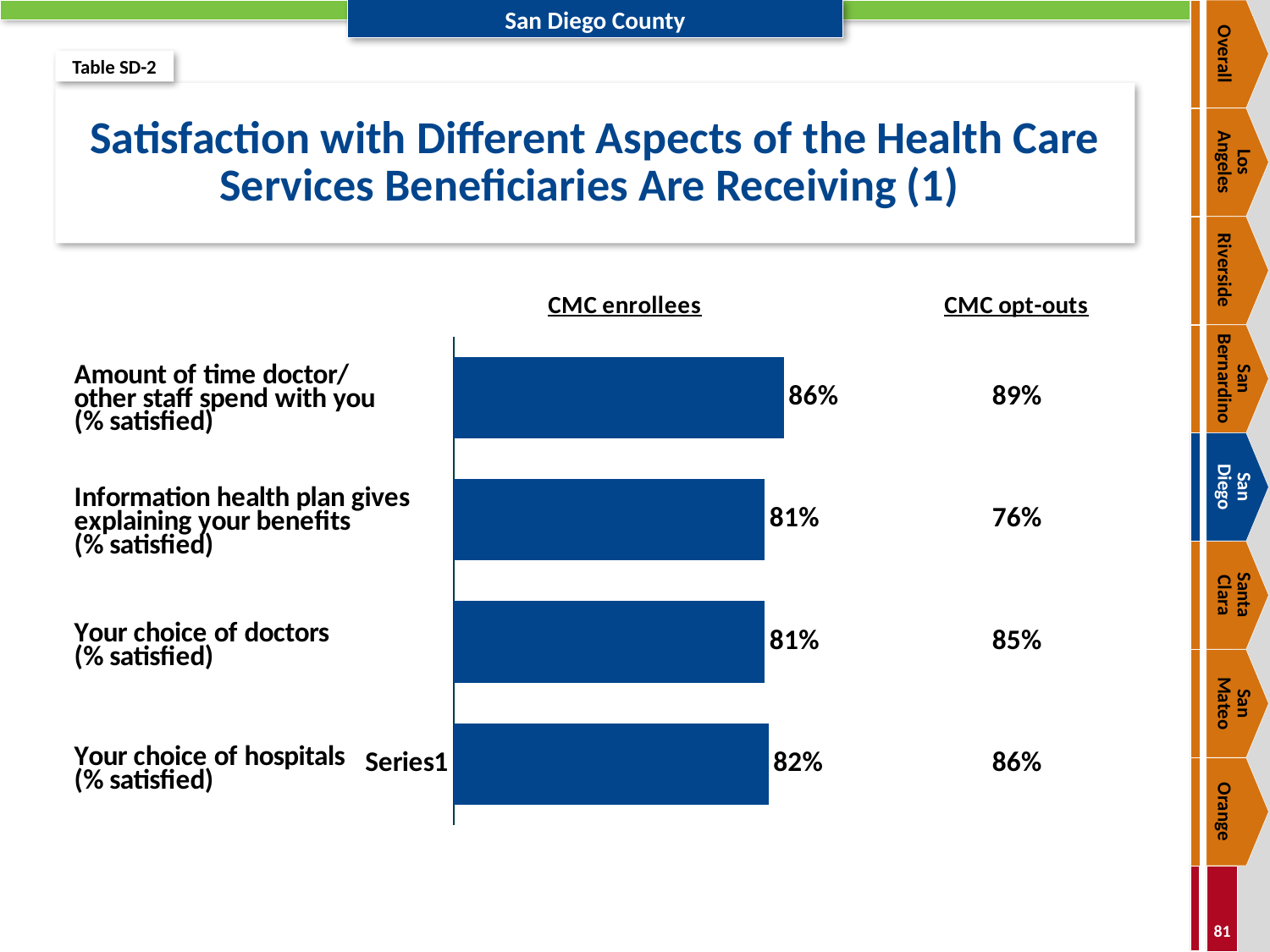
What is the title of the chart on the slide? Satisfaction with Different Aspects of the Health Care Services Beneficiaries Are Receiving (1) What is the CMC enrollees value for 'Amount of time doctor/other staff spend with you (% satisfied)'? 86% How many categories are shown in the chart? 4 What is the CMC opt-outs value for 'Information health plan gives explaining your benefits (% satisfied)'? 76% What is the CMC enrollees value for 'Your choice of hospitals (% satisfied)'? 82% For 'Information health plan gives explaining your benefits (% satisfied)', which is larger: the CMC enrollees value or the CMC opt-outs value? CMC enrollees Which category has the highest CMC enrollees value? Amount of time doctor/other staff spend with you (% satisfied) What kind of chart is shown on the slide? Bar chart Which category has the lowest CMC opt-outs value? Information health plan gives explaining your benefits (% satisfied) For 'Amount of time doctor/other staff spend with you (% satisfied)', which is larger: the CMC enrollees value or the CMC opt-outs value? CMC opt-outs What is the CMC opt-outs value for 'Your choice of doctors (% satisfied)'? 85% What is the difference between the CMC enrollees and CMC opt-outs values for 'Your choice of hospitals (% satisfied)'? 4%